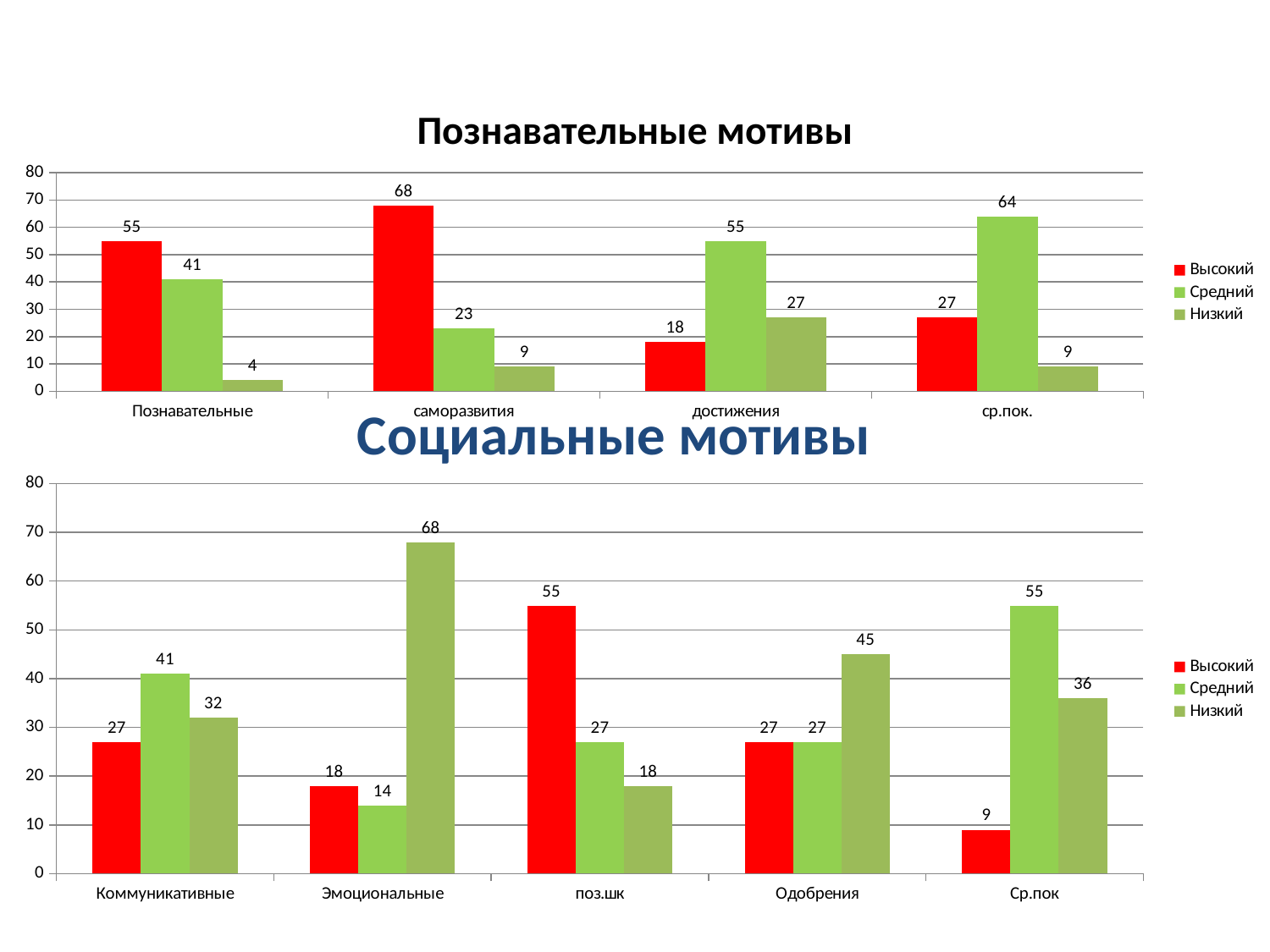
In the 'Познавательные мотивы' chart, what is the value of Высокий for саморазвития? 68 In the 'Социальные мотивы' chart, what is the difference between Низкий and Высокий for Одобрения? 18 In the 'Социальные мотивы' chart, how many categories are shown on the x axis? 5 In the 'Социальные мотивы' chart, what is the value of Низкий for Эмоциональные? 68 In the 'Познавательные мотивы' chart, how many categories are shown on the x axis? 4 In the 'Познавательные мотивы' chart, what is the value of Низкий for Познавательные? 4 In the 'Социальные мотивы' chart, which is larger for Коммуникативные: Средний or Низкий? Средний In the 'Социальные мотивы' chart, which category has the lowest Высокий value? Ср.пок How many series does the legend of the 'Социальные мотивы' chart list? 3 In the 'Познавательные мотивы' chart, what is the difference between Средний and Высокий for достижения? 37 What type of chart is the 'Познавательные мотивы' chart? Bar chart In the 'Познавательные мотивы' chart, which category has the highest Средний value? ср.пок.